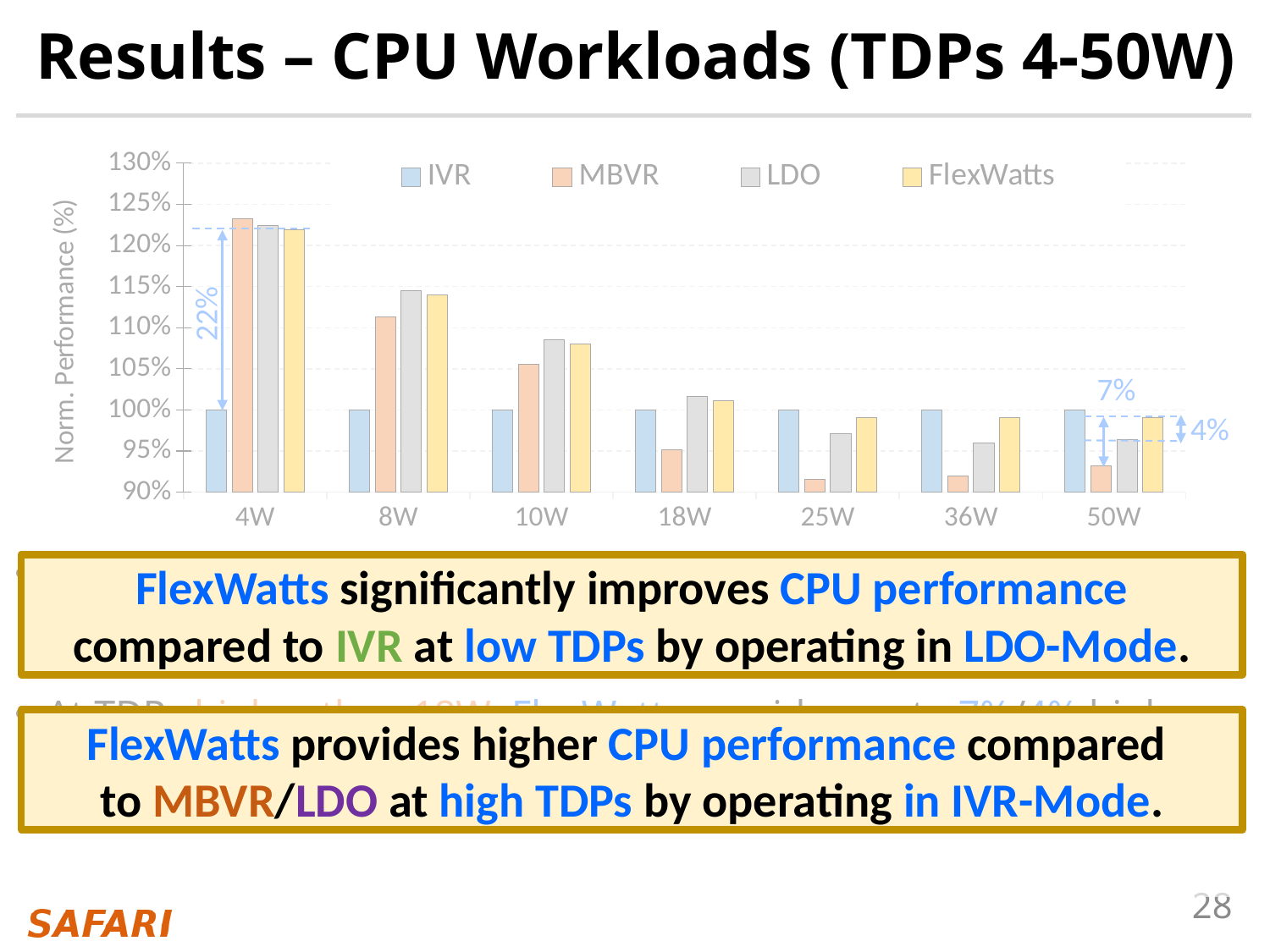
Does the MBVR value rise or fall from 4W to 25W? fall Is the value for MBVR at 4W greater or less than 120%? greater Is the value for FlexWatts at 10W greater or less than 105%? greater Which series has the lowest value at 25W? MBVR How many TDP categories are shown on the x axis? 7 At 18W, which is larger, MBVR or LDO? LDO Is the value for MBVR at 25W greater or less than 95%? less What is the value for IVR at 4W? 100% What is the value for IVR at 50W? 100% Which series has the lowest value at 4W? IVR What kind of chart is shown on the slide? bar chart How many series does the legend list? 4